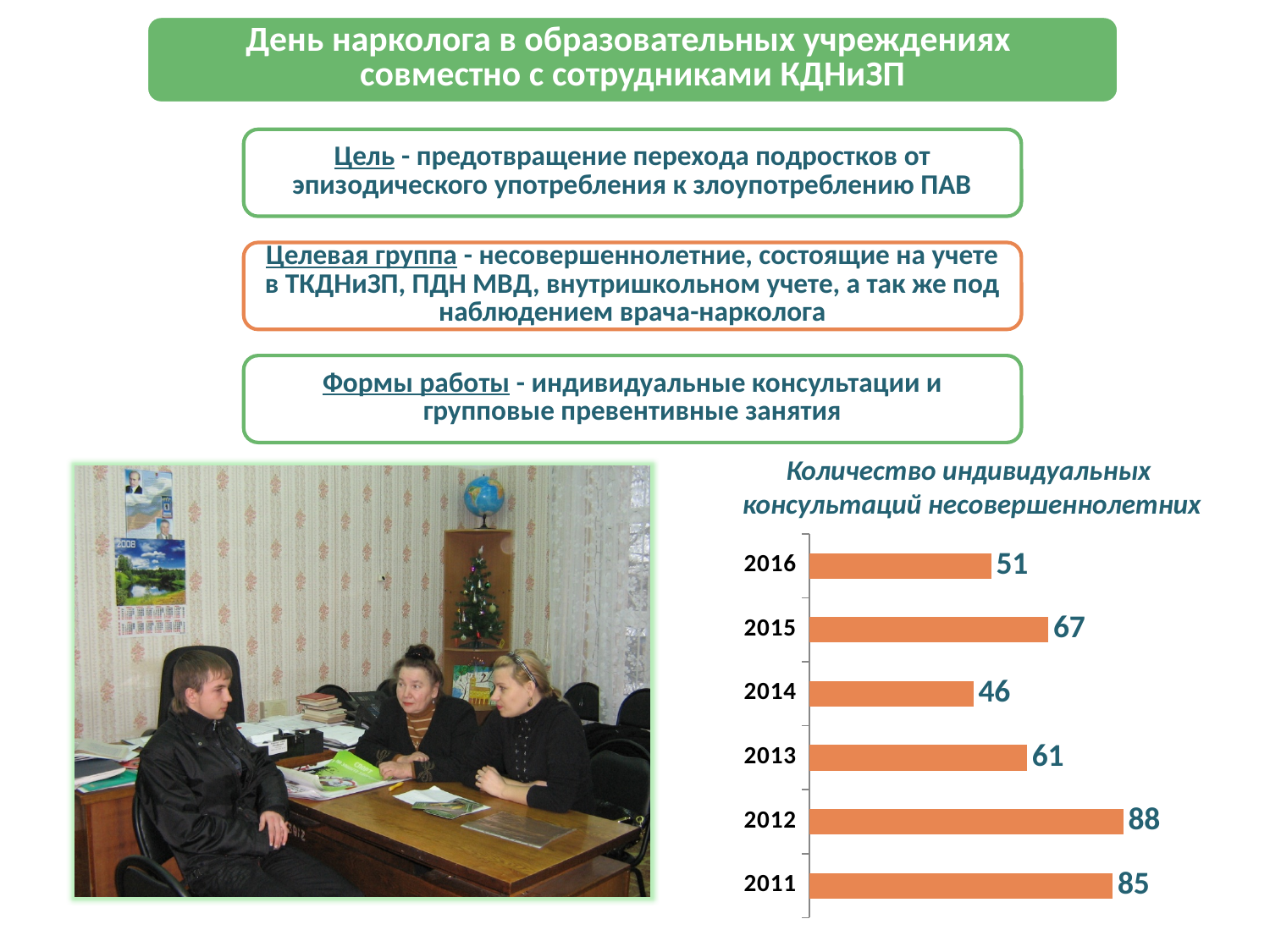
What is the title of the chart? Количество индивидуальных консультаций несовершеннолетних Which year has the highest value in the chart? 2012 What is the value for 2016 in the chart? 51 Which year has the lowest value in the chart? 2014 Which is larger, the value for 2013 or the value for 2015? 2015 What is the difference between the values for 2015 and 2016? 16 How many years are shown in the chart? 6 What is the difference between the values for 2012 and 2011? 3 What is the value for 2012 in the chart? 88 What kind of chart is shown on the slide? bar chart What colour are the bars in the chart? orange What is the value for 2014 in the chart? 46